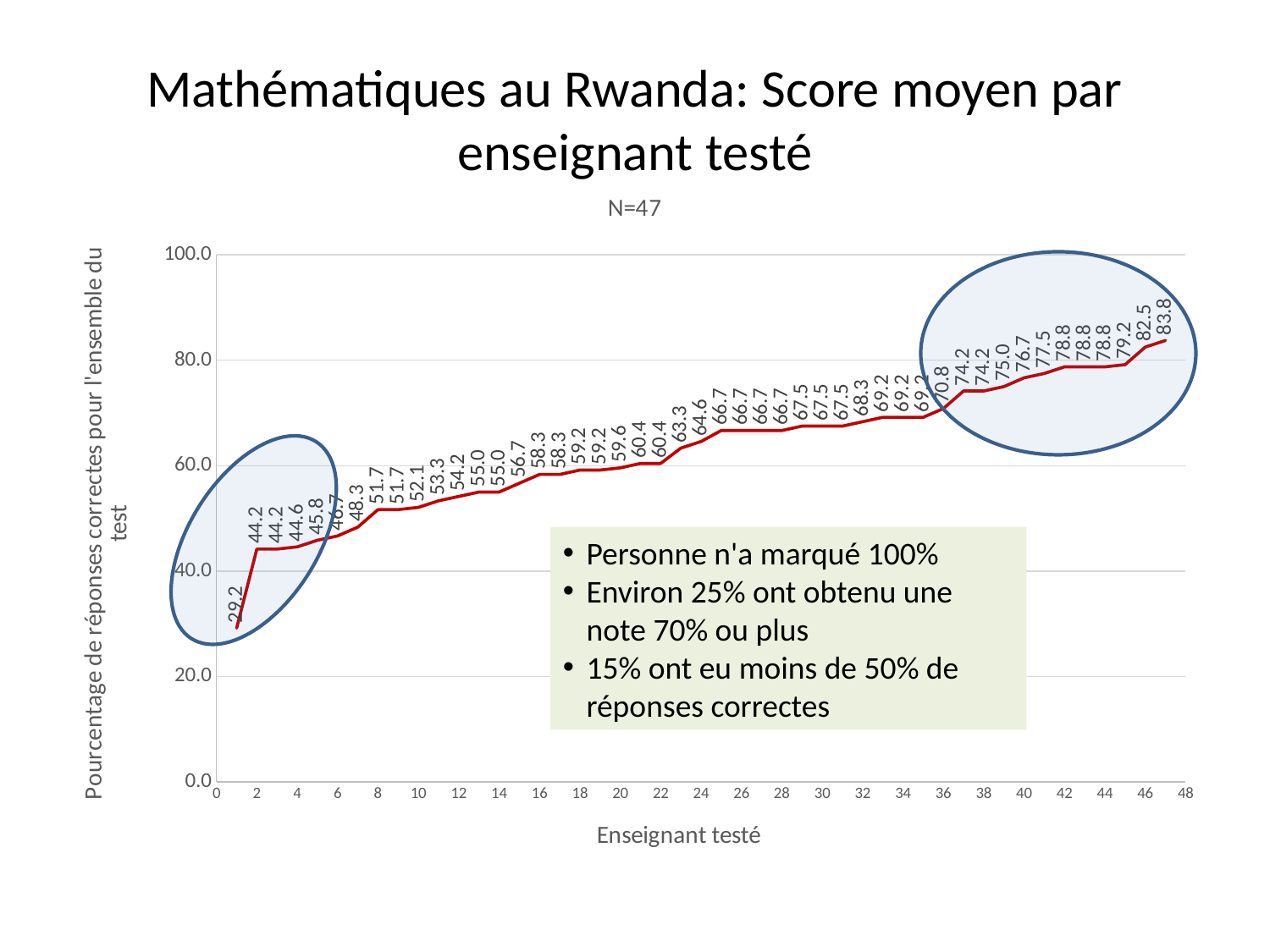
What is the highest score plotted on the chart? 83.8 What is the lowest score plotted on the chart? 29.2 Is the score of the last teacher tested greater or less than 80? greater What is the difference between the highest and lowest scores on the chart? 54.6 What is the score of the first teacher tested (x = 1)? 29.2 What kind of chart is shown on the slide? line chart What is the score of the last teacher tested (x = 47)? 83.8 Do the scores rise or fall as you move from left to right along the x axis? rise How many teachers (data points) are plotted on the chart? 47 Is the score of the first teacher tested greater or less than 40? less Which is larger, the score of the first teacher tested or the score of the second teacher tested? the second teacher tested What is the label of the x axis? Enseignant testé